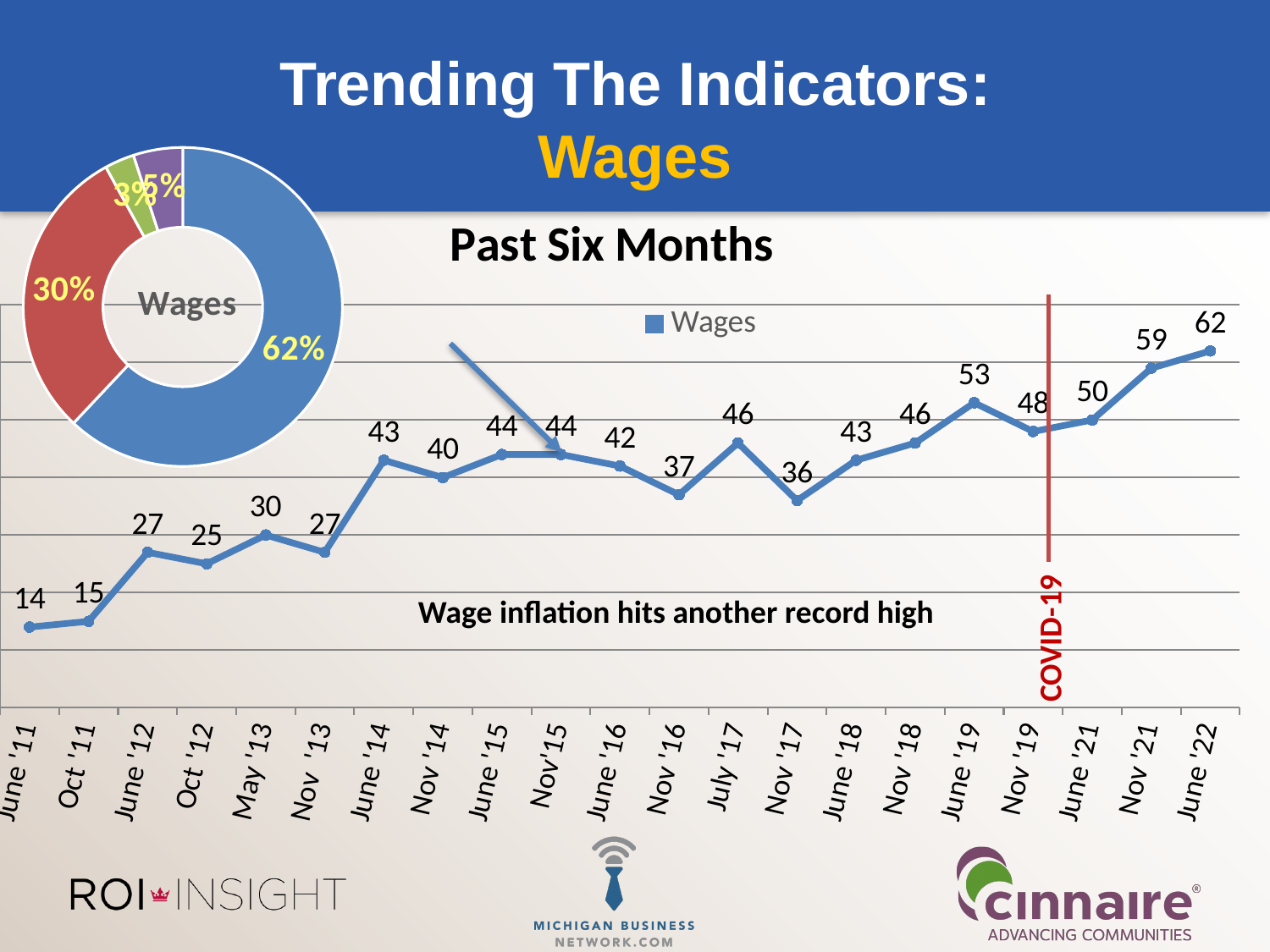
In the line chart titled "Past Six Months", which date has the highest value? June '22 In the line chart titled "Past Six Months", what is the value for June '22? 62 In the line chart titled "Past Six Months", how many series does the legend list? 1 What kind of chart is the chart titled "Past Six Months"? Line chart In the donut chart titled "Wages" at the top left, what share does the red slice have? 30% In the line chart titled "Past Six Months", what is the difference between the values for June '22 and June '19? 9 In the donut chart titled "Wages" at the top left, what share does the largest slice have? 62% In the line chart titled "Past Six Months", what is the value for June '11? 14 In the line chart titled "Past Six Months", how many data points are plotted? 21 In the line chart titled "Past Six Months", which date has the lowest value? June '11 In the line chart titled "Past Six Months", what is the value for Nov '17? 36 In the line chart titled "Past Six Months", which is larger, the value for Nov '16 or the value for July '17? July '17